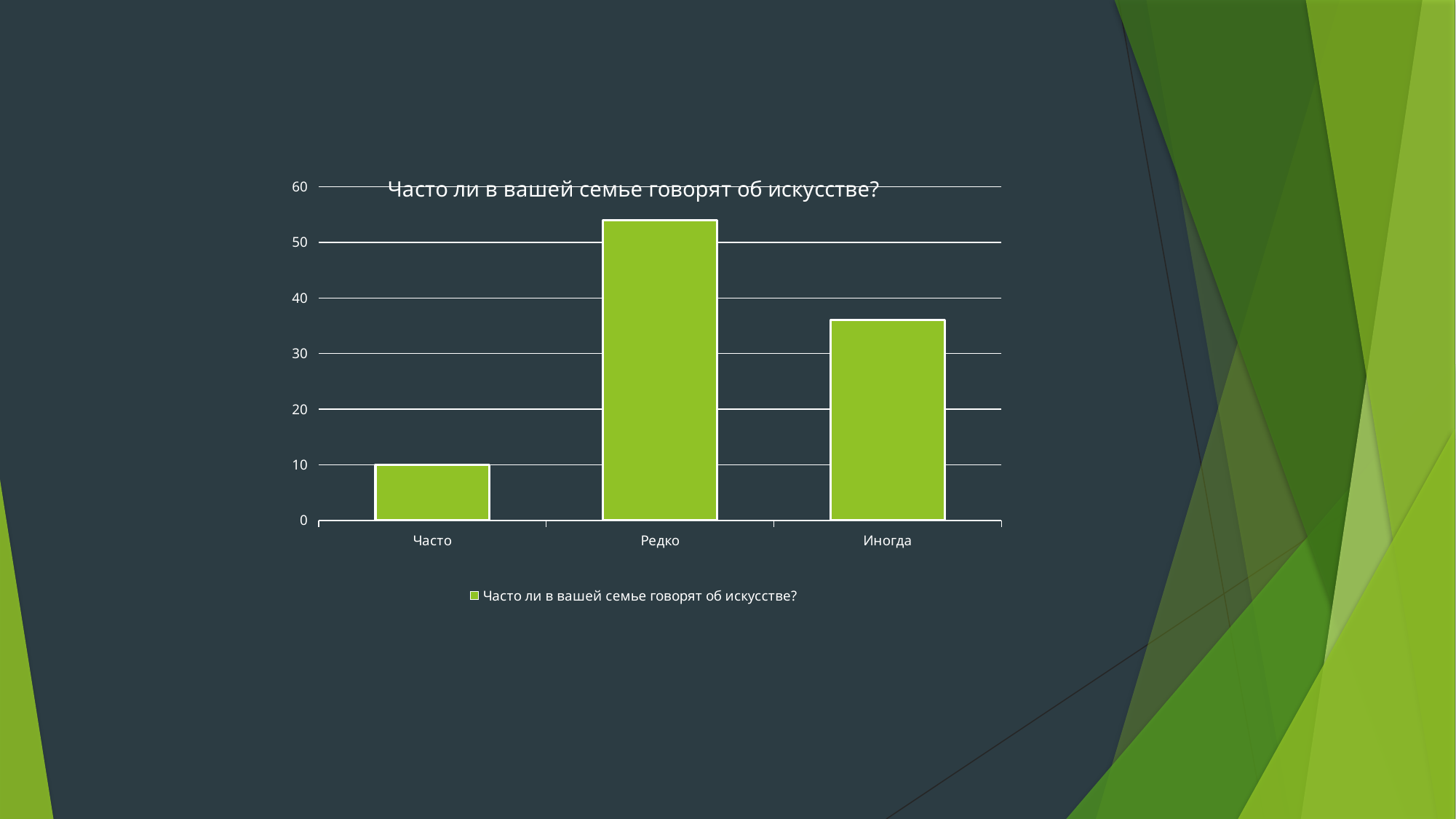
Which category has the lowest bar? Часто Is the value for Иногда greater or less than 40? less What colour are the bars in the chart? green Which is larger, the value for Иногда or the value for Часто? Иногда What kind of chart is shown on the slide? bar chart Is the value for Иногда greater or less than 30? greater Is the value for Редко greater or less than 50? greater What is the title of the chart? Часто ли в вашей семье говорят об искусстве? What is the value for Часто? 10 How many categories are shown on the x axis of the chart? 3 Which category has the highest bar? Редко How many series does the legend list? 1